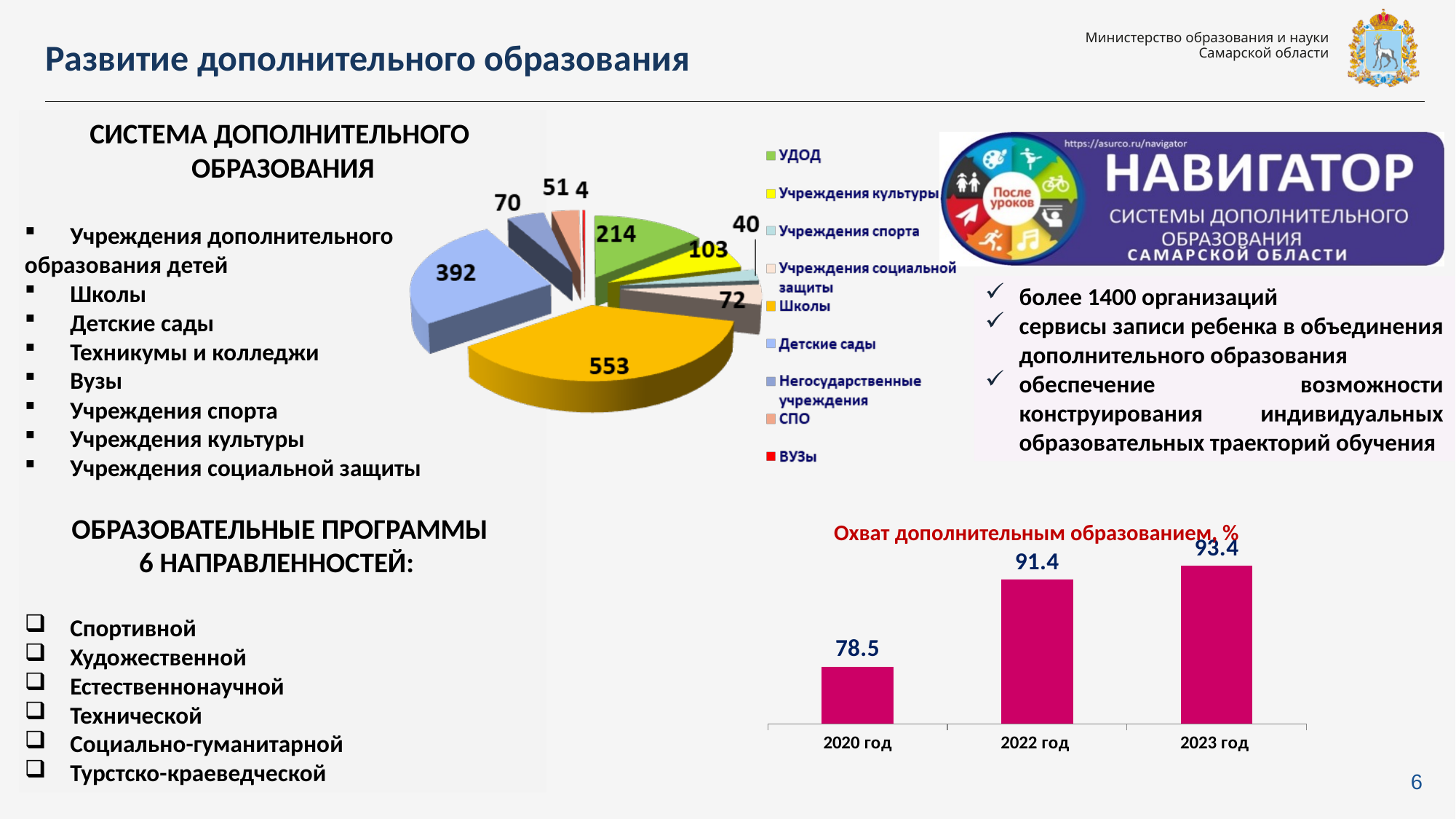
In the bar chart titled 'Охват дополнительным образованием, %', do the values rise or fall from 2020 год to 2023 год? rise In the bar chart titled 'Охват дополнительным образованием, %', which year has the lowest value? 2020 год In the bar chart titled 'Охват дополнительным образованием, %', what is the value for 2023 год? 93.4 In the pie chart in the upper middle of the slide, what is the value for Школы? 553 In the bar chart titled 'Охват дополнительным образованием, %', what is the value for 2020 год? 78.5 How many bars are in the bar chart titled 'Охват дополнительным образованием, %'? 3 In the pie chart in the upper middle of the slide, which is larger: УДОД or Учреждения культуры? УДОД In the pie chart in the upper middle of the slide, what is the value for Детские сады? 392 What kind of chart is the chart in the upper middle of the slide with the legend starting 'УДОД'? pie chart How many entries does the legend of the pie chart in the upper middle of the slide list? 9 In the bar chart titled 'Охват дополнительным образованием, %', what is the difference between the values for 2023 год and 2020 год? 14.9 In the pie chart in the upper middle of the slide, which category has the smallest value? ВУЗы